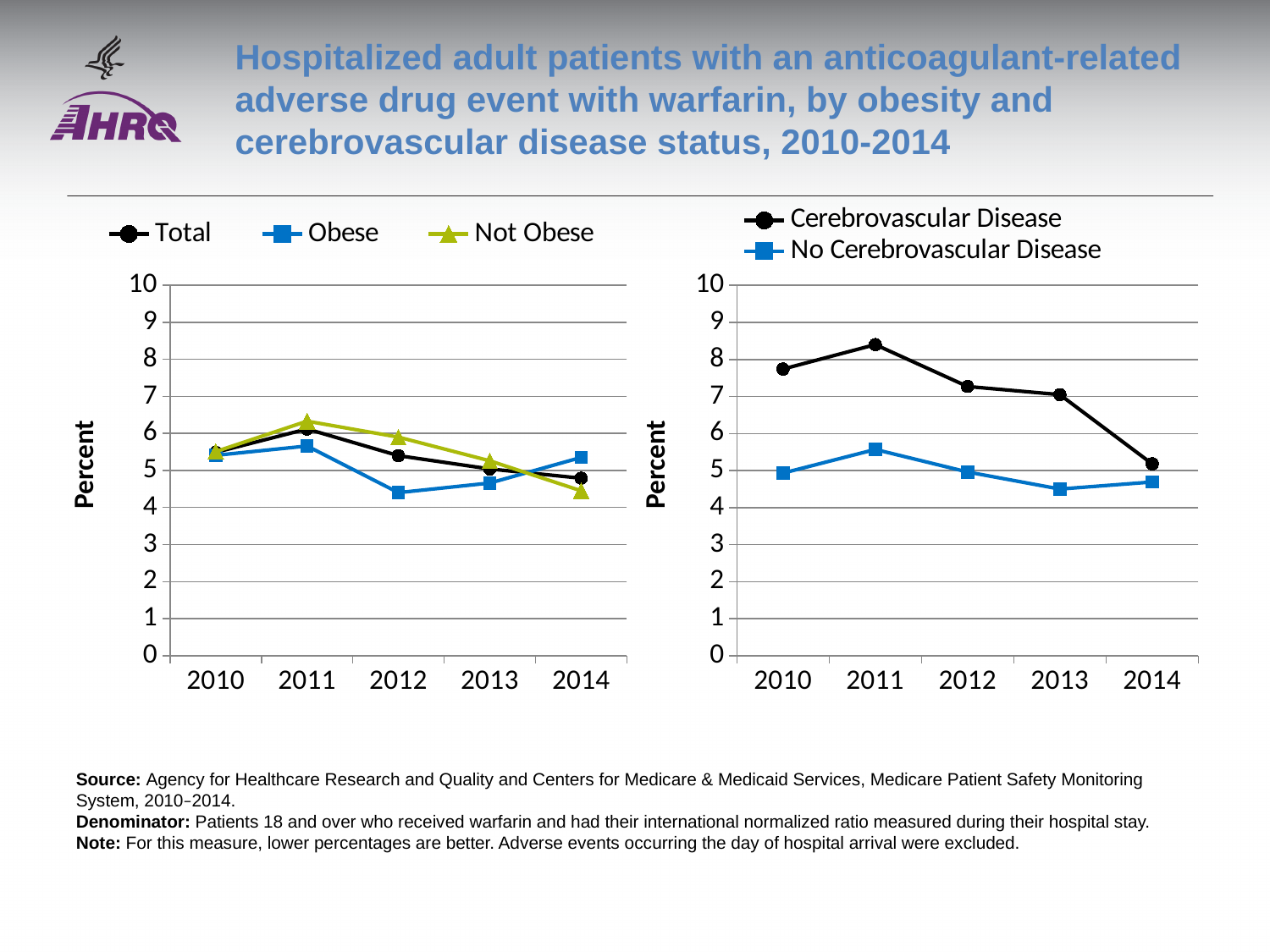
In the left chart (Total, Obese, Not Obese), how many years are plotted on the x axis? 5 In the left chart (Total, Obese, Not Obese), which is larger in 2014, Obese or Not Obese? Obese In the left chart (Total, Obese, Not Obese), how many series does the legend list? 3 In the right chart (Cerebrovascular Disease), in which year is the Cerebrovascular Disease series highest? 2011 In the left chart (Total, Obese, Not Obese), is the value for Obese in 2012 greater or less than 5? less In the left chart (Total, Obese, Not Obese), in which year is the Not Obese series highest? 2011 In the right chart (Cerebrovascular Disease), how many series does the legend list? 2 What kind of chart is the left chart (Total, Obese, Not Obese)? Line chart In the left chart (Total, Obese, Not Obese), is the value for Not Obese in 2011 greater or less than 6? greater In the right chart (Cerebrovascular Disease), in which year is the Cerebrovascular Disease series lowest? 2014 In the right chart (Cerebrovascular Disease), does the Cerebrovascular Disease series rise or fall from 2011 to 2014? Fall In the right chart (Cerebrovascular Disease), is the value for No Cerebrovascular Disease in 2013 greater or less than 5? less